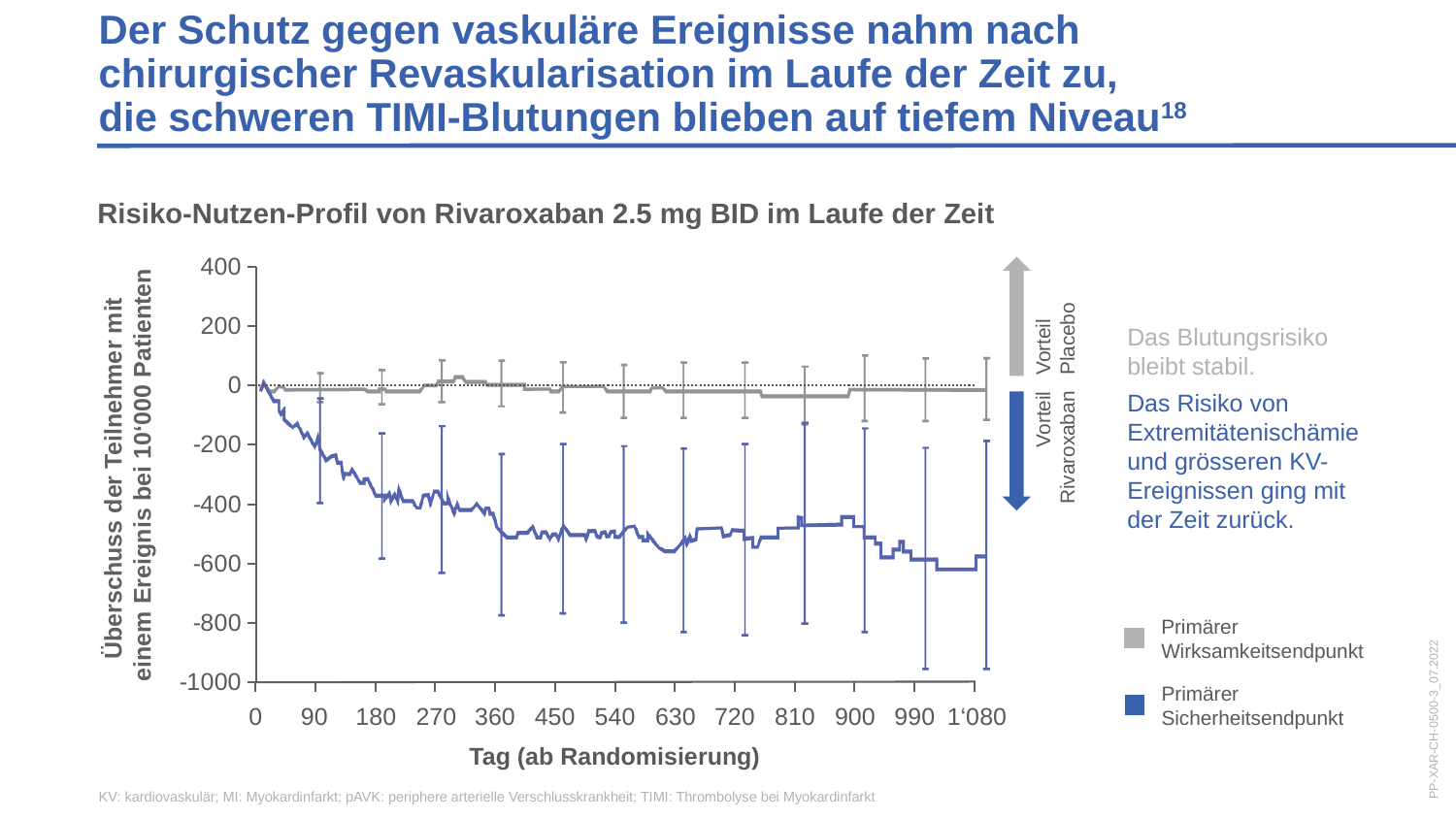
How many series does the legend list? 2 What is the lowest value shown on the y axis? -1000 Is the value of the blue line at day 630 greater or less than -400? less What kind of chart is shown on the slide? line chart Is the value of the blue line at day 360 greater or less than -200? less Is the value of the blue line at day 1'080 greater or less than -400? less How many tick labels are shown on the x axis? 13 What is the label of the x axis? Tag (ab Randomisierung) What is the title of the chart? Risiko-Nutzen-Profil von Rivaroxaban 2.5 mg BID im Laufe der Zeit Does the blue line rise or fall as the days since randomisation increase? fall At day 900, which line has the higher value, the grey line or the blue line? the grey line